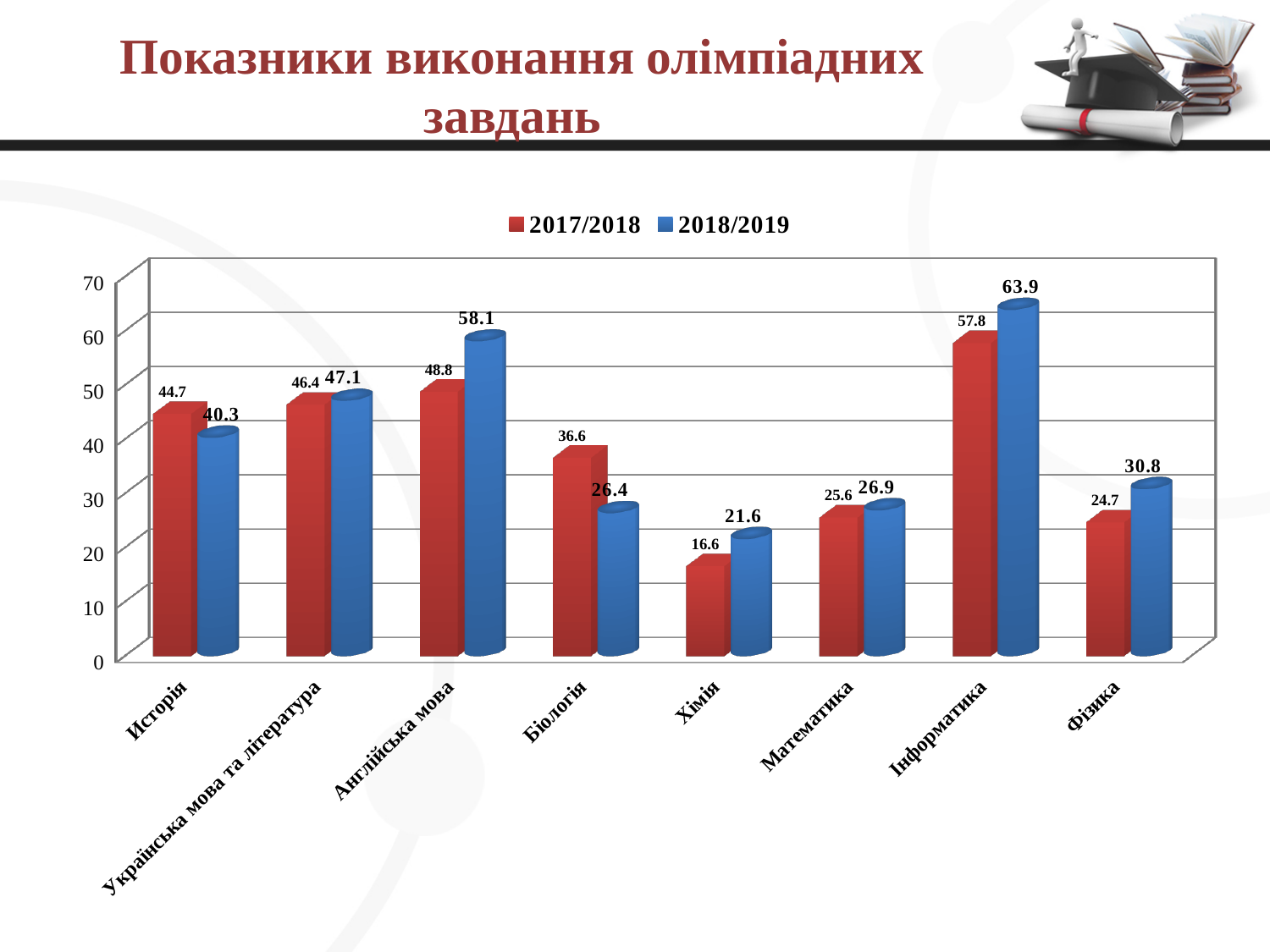
Which category has the lowest value in the 2017/2018 series? Хімія What kind of chart is shown on the slide? Bar chart Which colour represents the 2018/2019 series? Blue Is the 2018/2019 value for Фізика greater or less than 30? greater What is the value for Інформатика in the 2018/2019 series? 63.9 Which category has the highest value in the 2018/2019 series? Інформатика What is the value for Хімія in the 2017/2018 series? 16.6 What is the difference between the 2018/2019 and 2017/2018 values for Англійська мова? 9.3 Which is larger for Історія: the 2017/2018 value or the 2018/2019 value? 2017/2018 How many series does the legend list? 2 What is the value for Біологія in the 2018/2019 series? 26.4 How many categories are shown on the x axis? 8